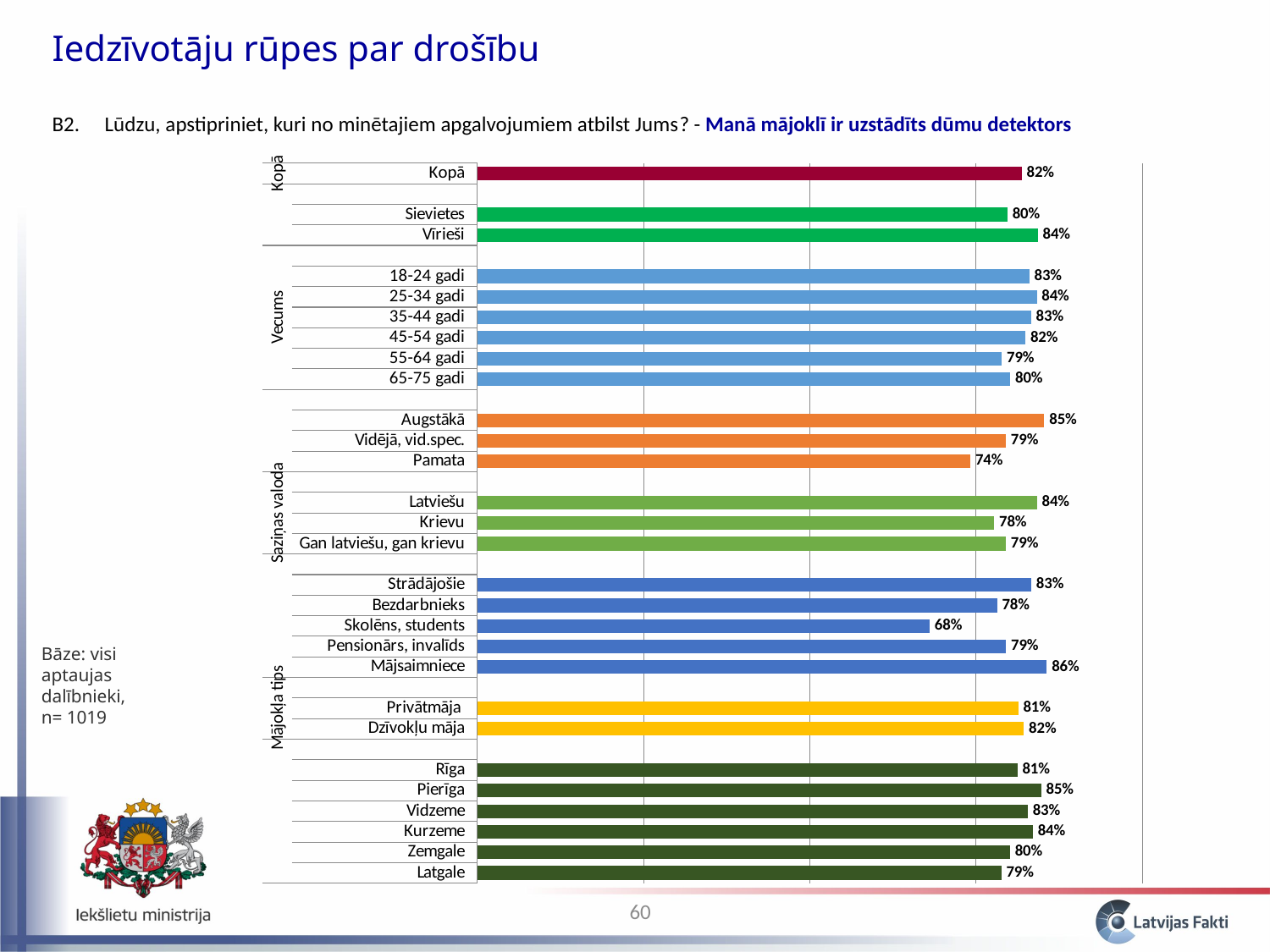
What is the value for Pierīga? 85% What is the value for Kopā? 82% What is the difference between the values for Vīrieši and Sievietes? 4% What is the difference between the values for Augstākā and Pamata? 11% Which has a larger value, Latviešu or Krievu? Latviešu Which category has the highest value in the chart? Mājsaimniece What is the value for Pamata? 74% Which region among Rīga, Pierīga, Vidzeme, Kurzeme, Zemgale and Latgale has the lowest value? Latgale How many bars are plotted in the chart? 28 What kind of chart is shown on the slide? Bar chart Which category has the lowest value in the chart? Skolēns, students What is the value for Skolēns, students? 68%